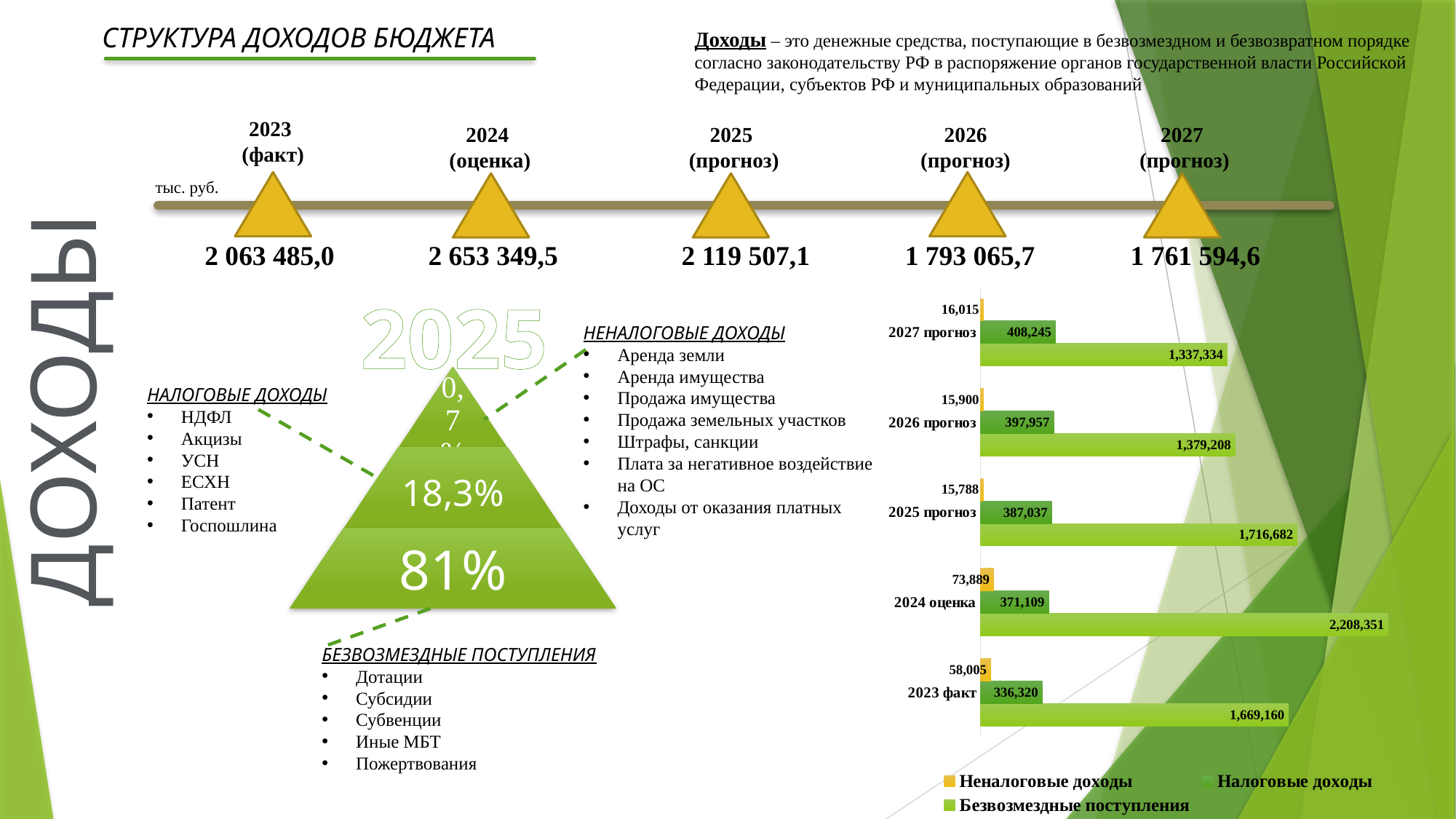
How many year categories are shown in the bar chart? 5 In the bar chart, do the values of Налоговые доходы rise or fall from 2023 факт to 2027 прогноз? rise In the bar chart, which year has the highest value of Безвозмездные поступления? 2024 оценка In the bar chart, what is the difference between Налоговые доходы for 2027 прогноз and 2026 прогноз? 10,288 In the bar chart, which is larger: Неналоговые доходы for 2024 оценка or for 2023 факт? 2024 оценка In the bar chart, which year has the lowest value of Неналоговые доходы? 2025 прогноз How many series does the legend of the bar chart list? 3 In the bar chart, what is the value of Налоговые доходы for 2025 прогноз? 387,037 In the bar chart, what is the value of Безвозмездные поступления for 2024 оценка? 2,208,351 In the bar chart, what is the value of Неналоговые доходы for 2023 факт? 58,005 What kind of chart is shown on the right side of the slide? bar chart In the bar chart, what is the value of Безвозмездные поступления for 2027 прогноз? 1,337,334